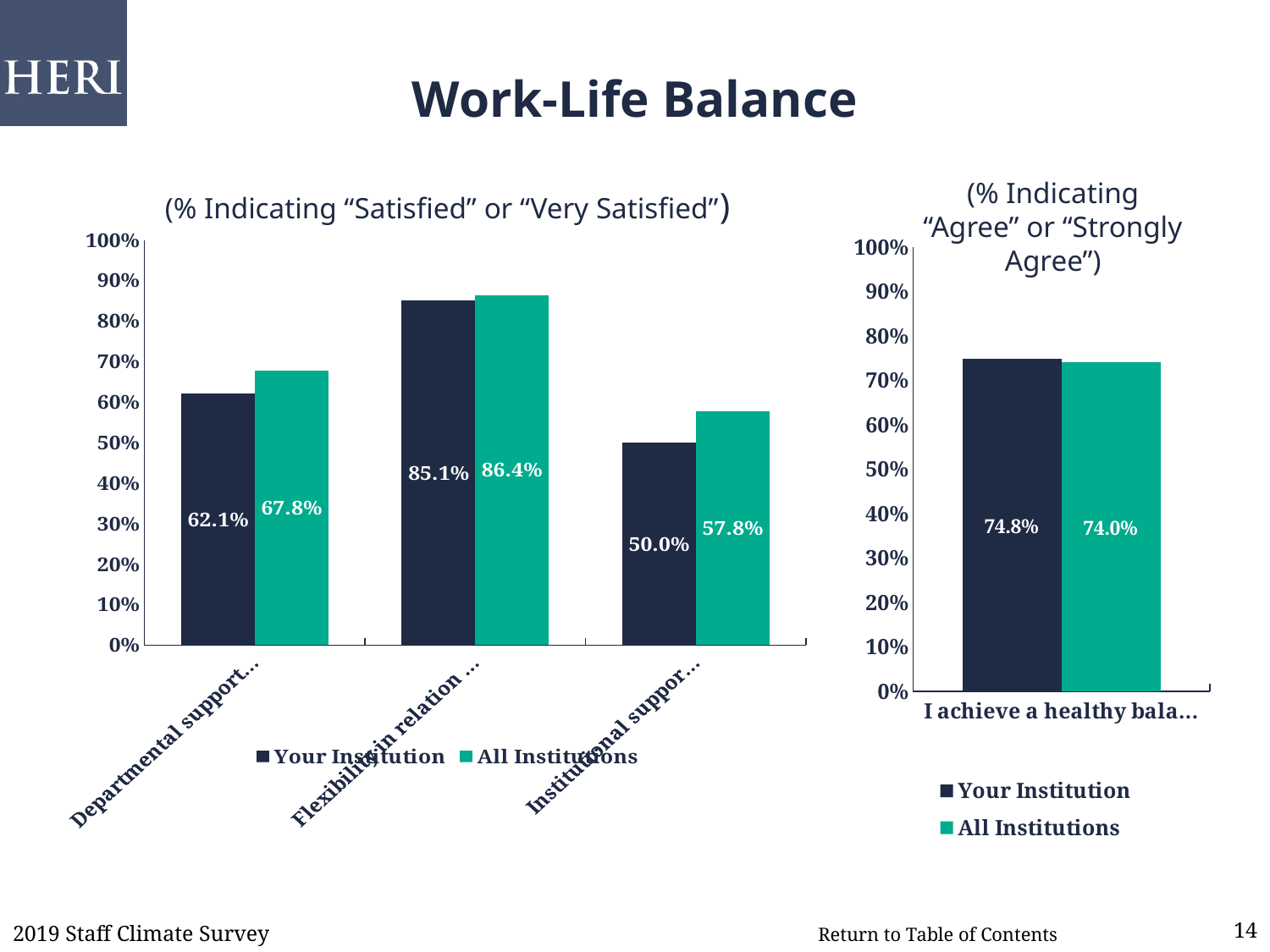
In the left chart (% Indicating "Satisfied" or "Very Satisfied"), which is larger for the Departmental support category: Your Institution or All Institutions? All Institutions In the right chart (% Indicating "Agree" or "Strongly Agree"), what is the difference between Your Institution and All Institutions? 0.8% In the left chart (% Indicating "Satisfied" or "Very Satisfied"), what is the difference between All Institutions and Your Institution for the Institutional support category? 7.8% How many categories are shown on the x axis of the left chart (% Indicating "Satisfied" or "Very Satisfied")? 3 In the left chart (% Indicating "Satisfied" or "Very Satisfied"), what is the value for Your Institution for the Departmental support category? 62.1% In the left chart (% Indicating "Satisfied" or "Very Satisfied"), which category has the highest value for Your Institution? Flexibility in relation ... In the right chart (% Indicating "Agree" or "Strongly Agree"), what is the value for Your Institution for "I achieve a healthy bala..."? 74.8% In the left chart (% Indicating "Satisfied" or "Very Satisfied"), which category has the lowest value for All Institutions? Institutional suppor... In the left chart (% Indicating "Satisfied" or "Very Satisfied"), what is the value for All Institutions for the Flexibility in relation category? 86.4% How many series does the legend of the left chart (% Indicating "Satisfied" or "Very Satisfied") list? 2 In the left chart (% Indicating "Satisfied" or "Very Satisfied"), what is the value for All Institutions for the Institutional support category? 57.8% What type of chart is the right chart (% Indicating "Agree" or "Strongly Agree")? Bar chart